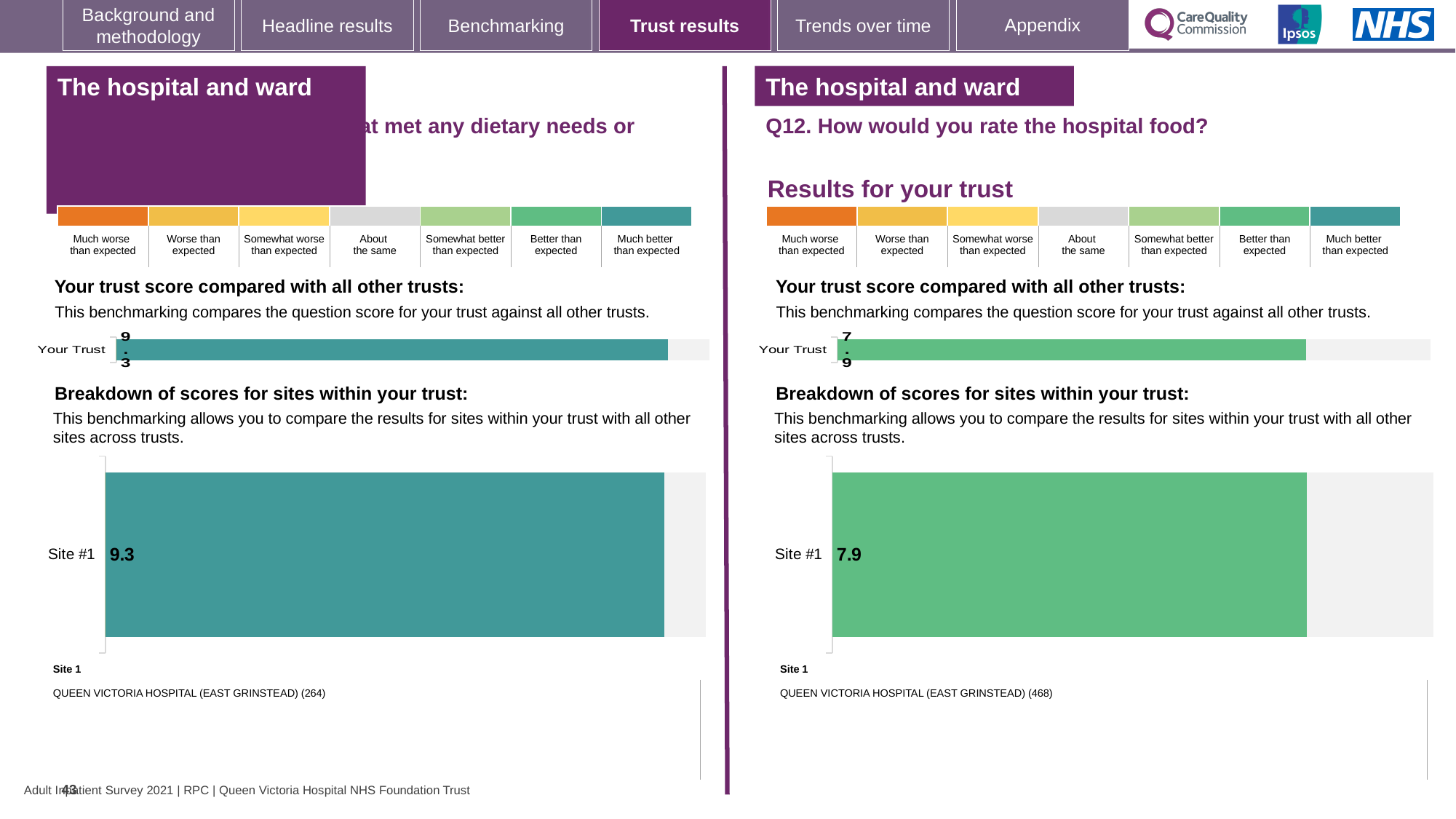
What is the name of the site listed as Site 1 on the right half of the slide (Q12, hospital food)? QUEEN VICTORIA HOSPITAL (EAST GRINSTEAD) (468) On the left half of the slide, what is the value shown for Your Trust in the trust score chart? 9.3 How many sites are shown in the breakdown of scores chart on the left half of the slide? 1 Which Site #1 score is larger: the one on the left half of the slide or the one on the right half (Q12, hospital food)? The left half (9.3) What is the difference between the Site #1 score on the left half of the slide and the Site #1 score on the right half (Q12, hospital food)? 1.4 On the left half of the slide, which benchmark category colour does the Site #1 bar match? Much better than expected On the right half of the slide (Q12, hospital food), what is the score shown for Site #1 in the breakdown of scores for sites chart? 7.9 On the right half of the slide (Q12, hospital food), which benchmark category colour does the Site #1 bar match? Better than expected On the left half of the slide, what is the score shown for Site #1 in the breakdown of scores for sites chart? 9.3 How many sites are shown in the breakdown of scores chart on the right half of the slide (Q12, hospital food)? 1 On the right half of the slide (Q12, hospital food), what is the value shown for Your Trust in the trust score chart? 7.9 What kind of chart is used to show the Site #1 score on the right half of the slide (Q12, hospital food)? Bar chart